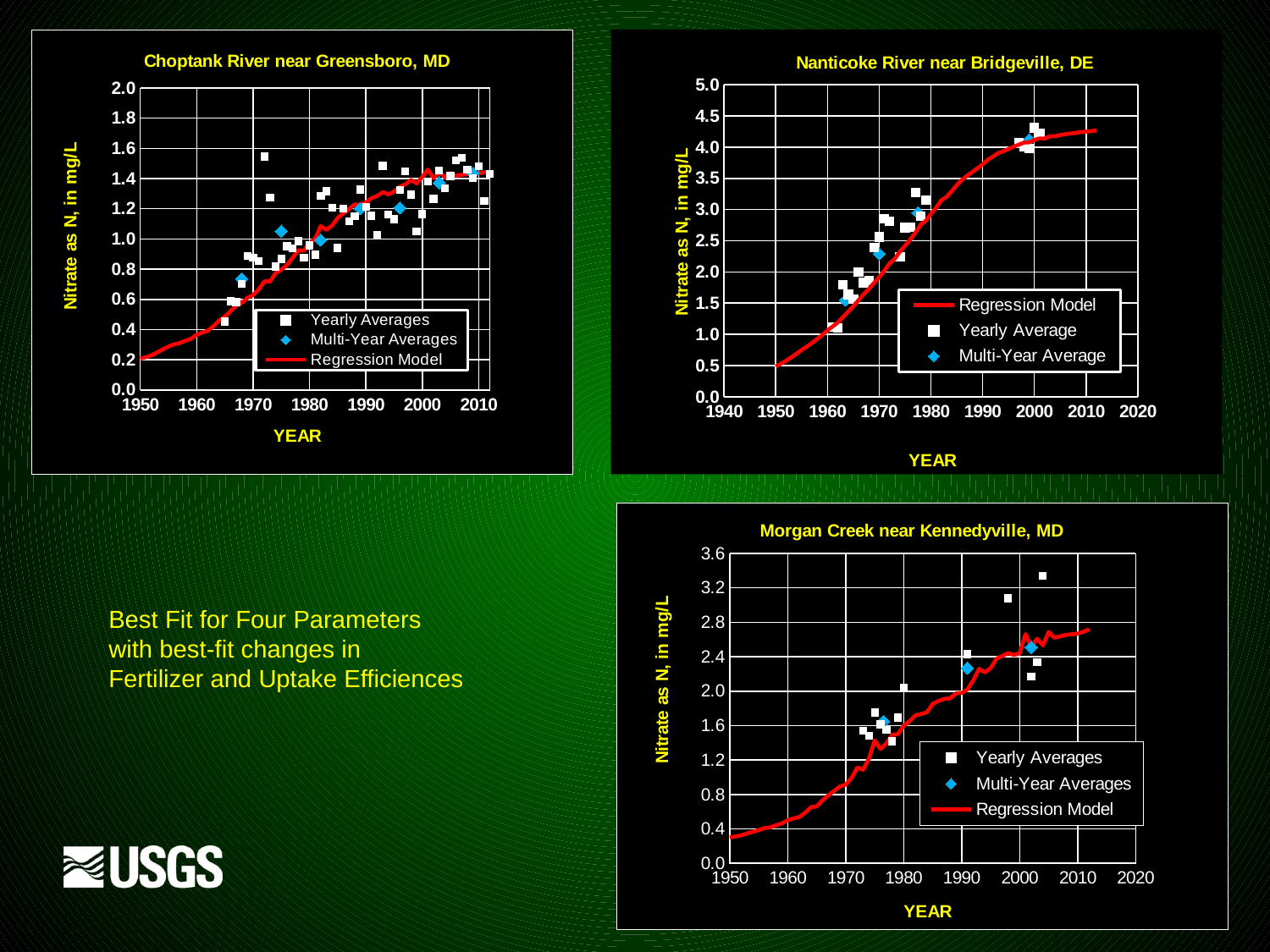
How many Multi-Year Average points are plotted on the 'Morgan Creek near Kennedyville, MD' chart? 3 On the 'Nanticoke River near Bridgeville, DE' chart, is the Multi-Year Average plotted near 2000 greater or less than 3.5 mg/L? greater How many series does the legend list on the 'Nanticoke River near Bridgeville, DE' chart? 3 On the 'Morgan Creek near Kennedyville, MD' chart, do the nitrate values rise or fall over the years? rise What kind of chart is the 'Choptank River near Greensboro, MD' chart? scatter chart with a regression line What is the y-axis label on the 'Nanticoke River near Bridgeville, DE' chart? Nitrate as N, in mg/L On the 'Choptank River near Greensboro, MD' chart, is the Multi-Year Average plotted near 1968 greater or less than 1.0 mg/L? less On the 'Choptank River near Greensboro, MD' chart, is the Multi-Year Average plotted near 2003 greater or less than 1.2 mg/L? greater On the 'Choptank River near Greensboro, MD' chart, what colour is the Regression Model line? red How many Multi-Year Average points are plotted on the 'Nanticoke River near Bridgeville, DE' chart? 4